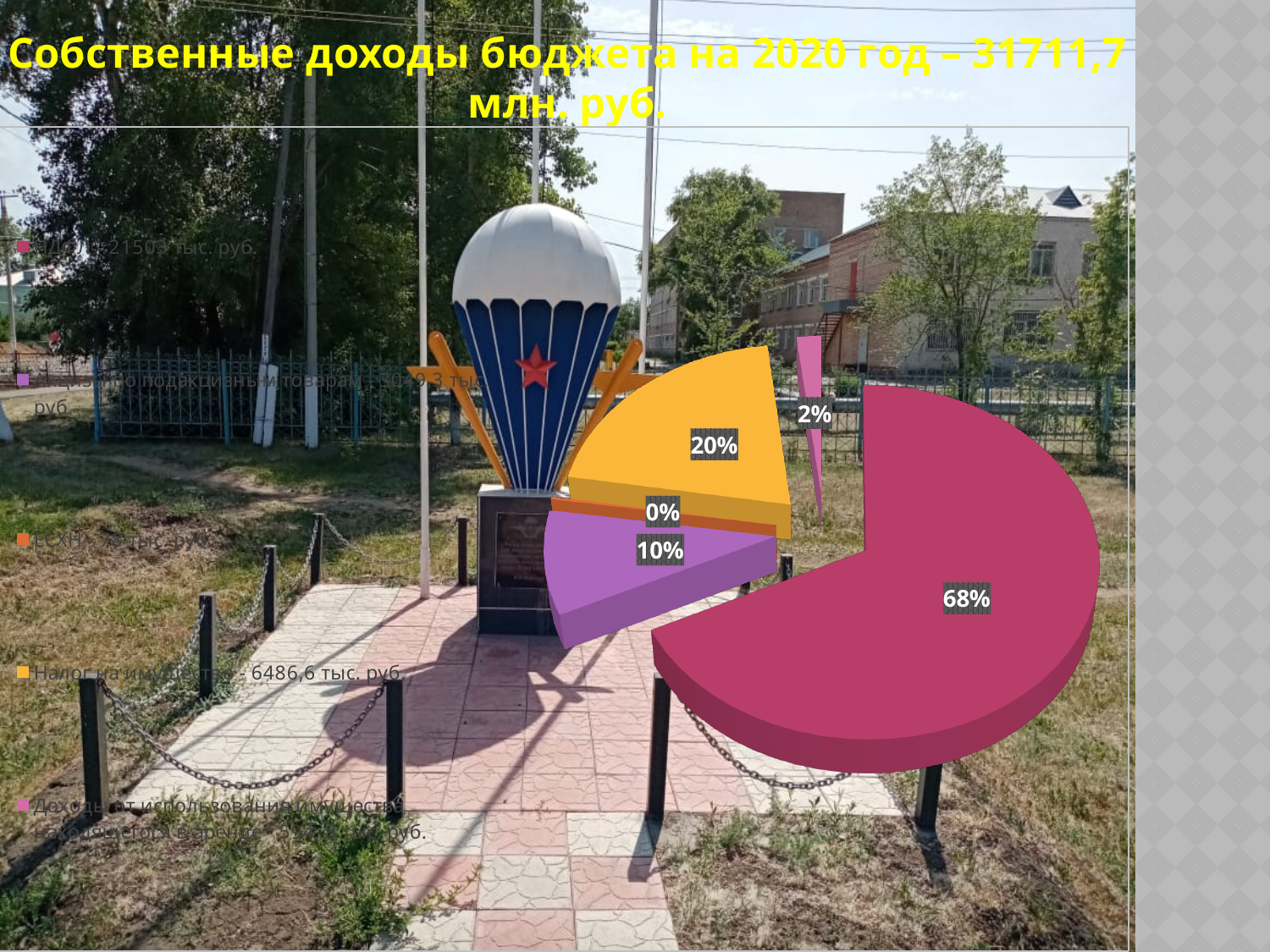
Is the largest slice of the pie chart greater or less than 50%? greater What is the share of the purple slice on the pie chart? 10% What kind of chart is shown on the slide? pie chart What is the smallest share labelled on the pie chart? 0% What colour is the largest slice of the pie chart? magenta (dark pink) What is the share of the orange slice on the pie chart? 20% What total amount of own budget revenues for 2020 is stated in the slide title? 31711,7 млн. руб. Which is larger on the pie chart, the orange slice or the purple slice? the orange slice What is the largest share shown on the pie chart? 68% How many slices are labelled with percentages on the pie chart? 5 What is the difference in percentage points between the largest slice (68%) and the orange slice (20%)? 48 percentage points What is the share of the small pink slice on the pie chart? 2%